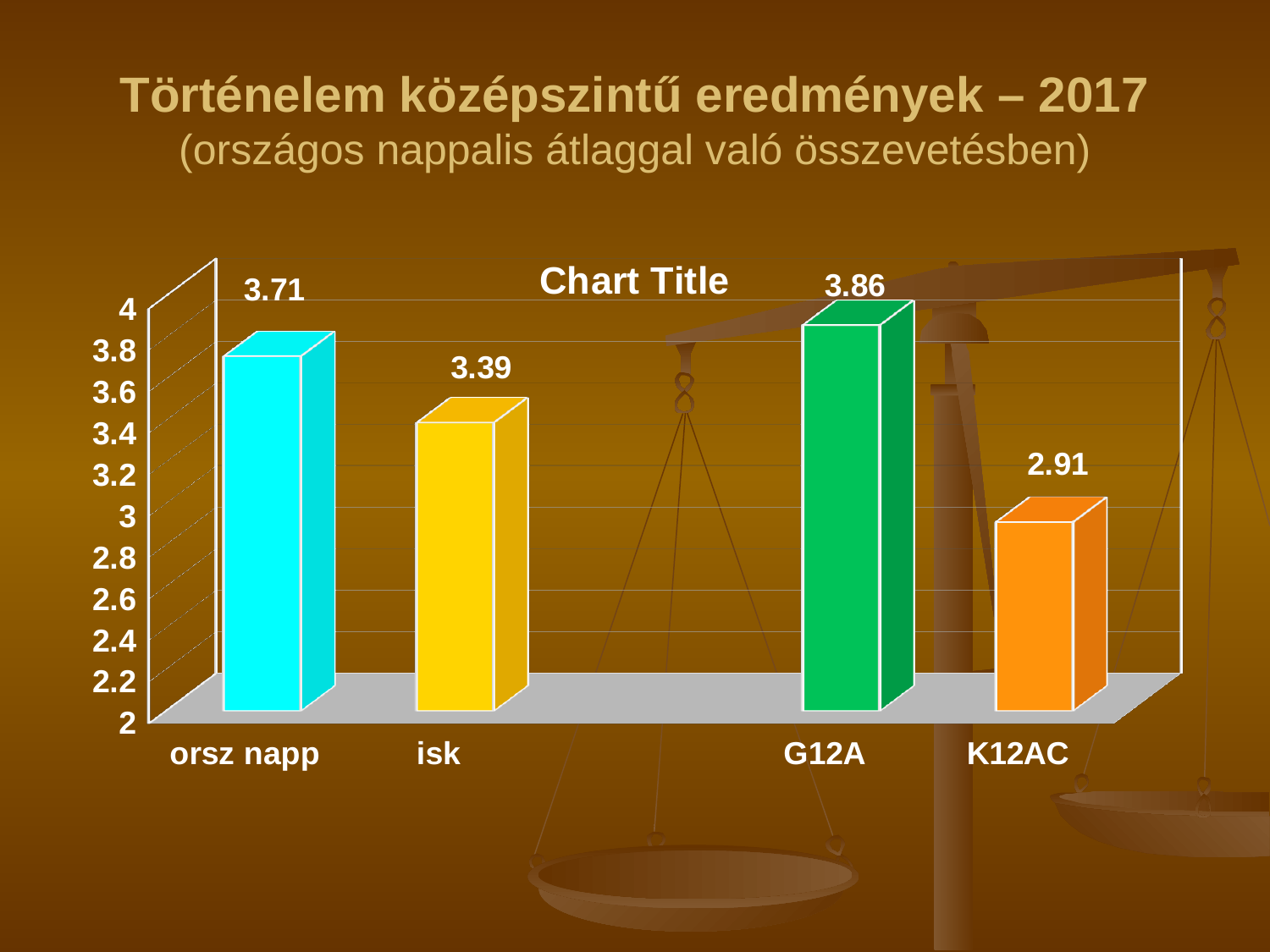
What is the value for isk? 3.39 What is the value for K12AC? 2.91 What is the difference between the values for G12A and K12AC? 0.95 What is the difference between the values for orsz napp and isk? 0.32 Is the value for K12AC greater or less than 3? less How many bars are plotted in the chart? 4 What is the value for orsz napp? 3.71 Which category has the highest value? G12A Which is larger, the value for isk or the value for G12A? G12A What is the value for G12A? 3.86 What kind of chart is shown on the slide? bar chart Which category has the lowest value? K12AC